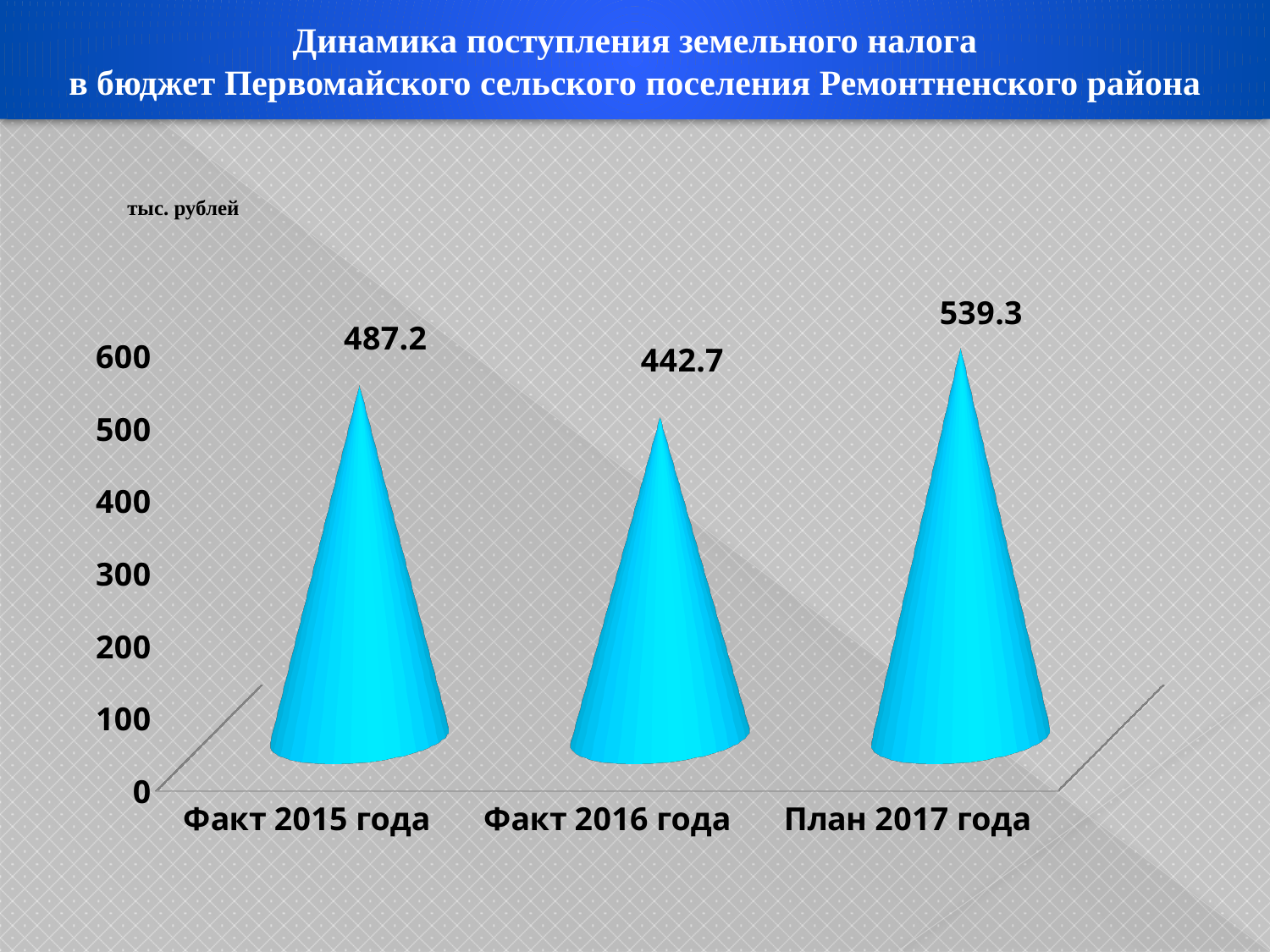
What is the value for План 2017 года? 539.3 Is the value for План 2017 года greater or less than 500? greater Which category has the highest value? План 2017 года What kind of chart is shown on the slide? bar chart What unit is indicated for the values on the chart? тыс. рублей What is the difference between the values for Факт 2015 года and Факт 2016 года? 44.5 How many categories are shown on the x axis? 3 What is the difference between the values for План 2017 года and Факт 2016 года? 96.6 What is the value for Факт 2015 года? 487.2 Which category has the lowest value? Факт 2016 года Which is larger, the value for Факт 2015 года or Факт 2016 года? Факт 2015 года What is the value for Факт 2016 года? 442.7